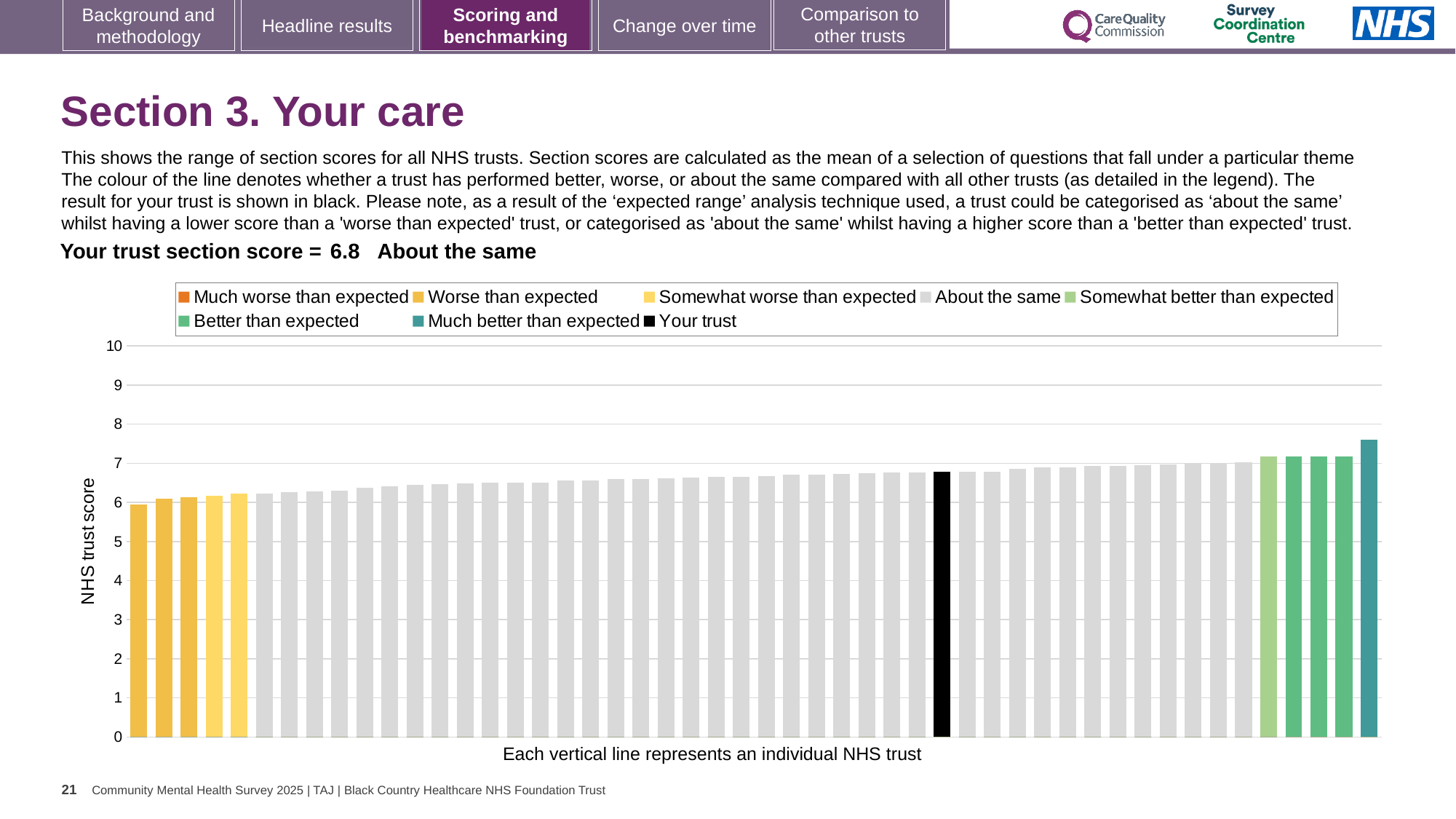
How many entries does the chart legend list? 8 What is the highest tick value shown on the vertical axis? 10 Which is larger, the value of the black 'Your trust' bar or the value of the leftmost bar? Your trust How many bars are coloured as 'Much better than expected'? 1 Is the value for the tallest bar (the 'Much better than expected' trust) greater or less than 7? greater Is the value for the black 'Your trust' bar greater or less than 6? greater Is the value for the leftmost bar greater or less than 7? less What is the section score for your trust? 6.8 Do the bar values rise or fall from left to right along the x axis? rise What is the label on the vertical axis of the chart? NHS trust score Which category is your trust placed in for this section? About the same What kind of chart is shown on the slide? bar chart